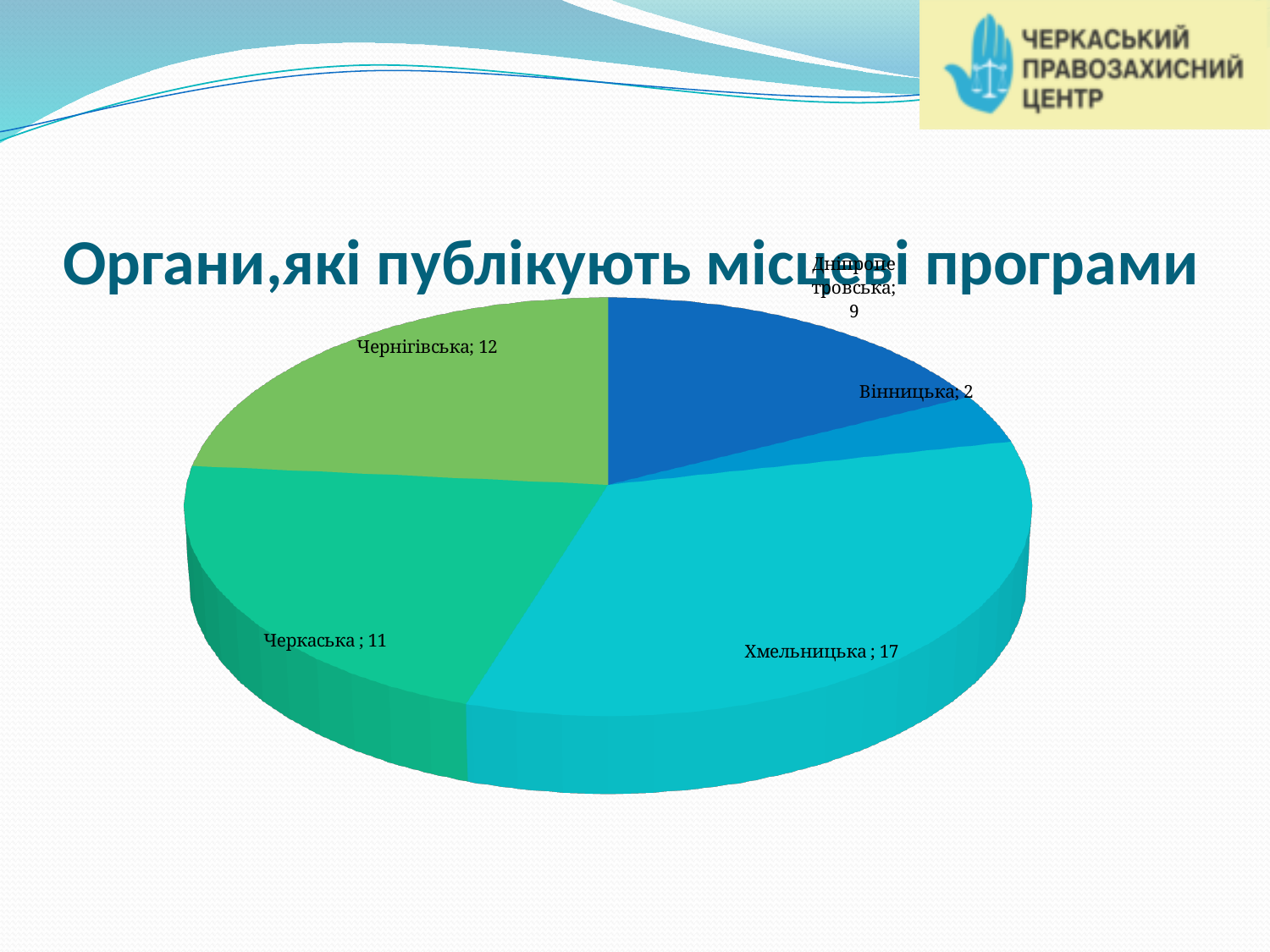
What is the difference between the values for Хмельницька and Чернігівська? 5 What is the title of the chart? Органи,які публікують місцеві програми What is the value for Хмельницька? 17 Which region has the smallest slice? Вінницька What is the value for Дніпропетровська? 9 What is the total of all slices in the pie chart? 51 How many slices does the pie chart have? 5 What is the value for Вінницька? 2 What type of chart is shown on the slide? pie chart Which region has the largest slice? Хмельницька Which is larger, the value for Чернігівська or the value for Черкаська? Чернігівська What is the value for Черкаська? 11